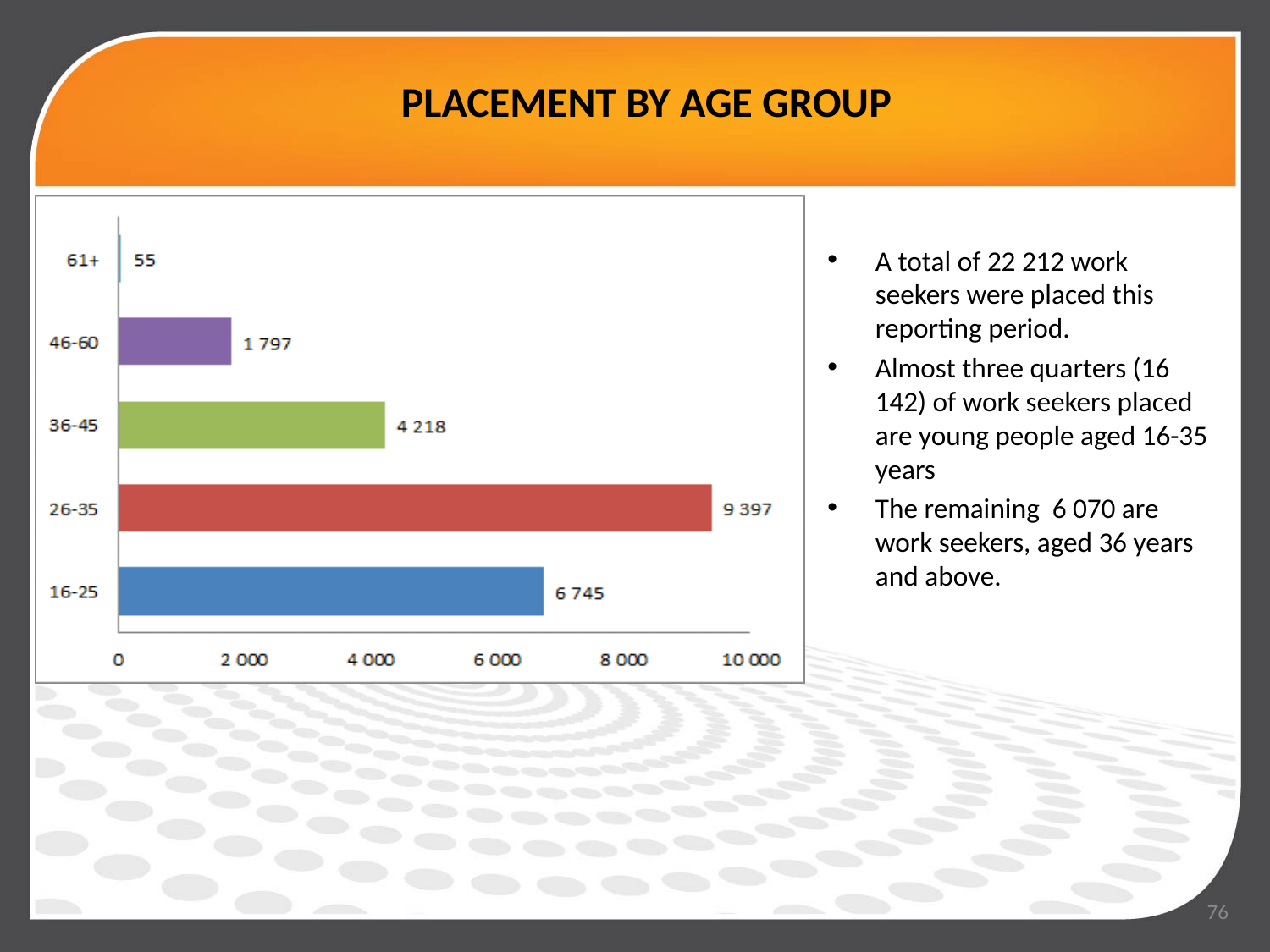
Which age group has the lowest placement value? 61+ What is the value for the 36-45 age group? 4 218 How many age groups are shown in the chart? 5 Which age group has a larger value, 36-45 or 46-60? 36-45 What kind of chart is shown on the slide? Bar chart What is the value for the 46-60 age group? 1 797 What is the value for the 26-35 age group? 9 397 What is the title of the slide containing the chart? PLACEMENT BY AGE GROUP Which age group has the highest placement value? 26-35 What is the value for the 61+ age group? 55 What is the difference between the values for the 26-35 and 16-25 age groups? 2 652 What is the value for the 16-25 age group? 6 745